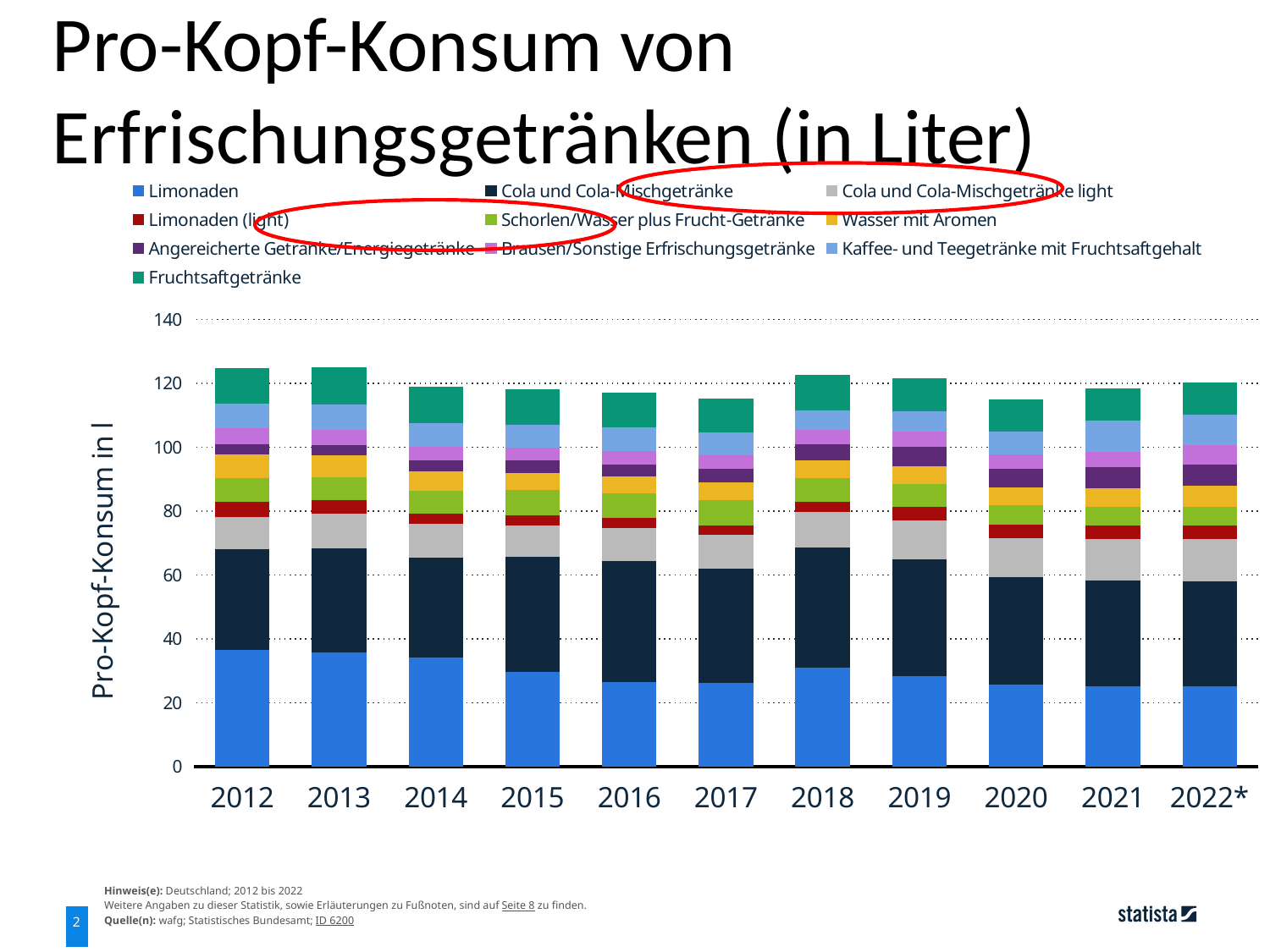
Is the Limonaden value for 2012 greater or less than 20 liters? greater Is the total per-capita consumption for 2017 greater or less than 120 liters? less Is the total per-capita consumption for 2012 greater or less than 120 liters? greater How many series does the legend list? 10 Which series forms the bottom segment of each stacked bar? Limonaden What is the label of the y axis? Pro-Kopf-Konsum in l Does the Limonaden segment rise or fall from 2012 to 2022*? Fall How many years are shown on the x axis of the chart? 11 Which year has the larger Limonaden value, 2012 or 2022*? 2012 Which year has the larger total per-capita consumption, 2012 or 2020? 2012 What kind of chart is shown on the slide? Stacked bar chart